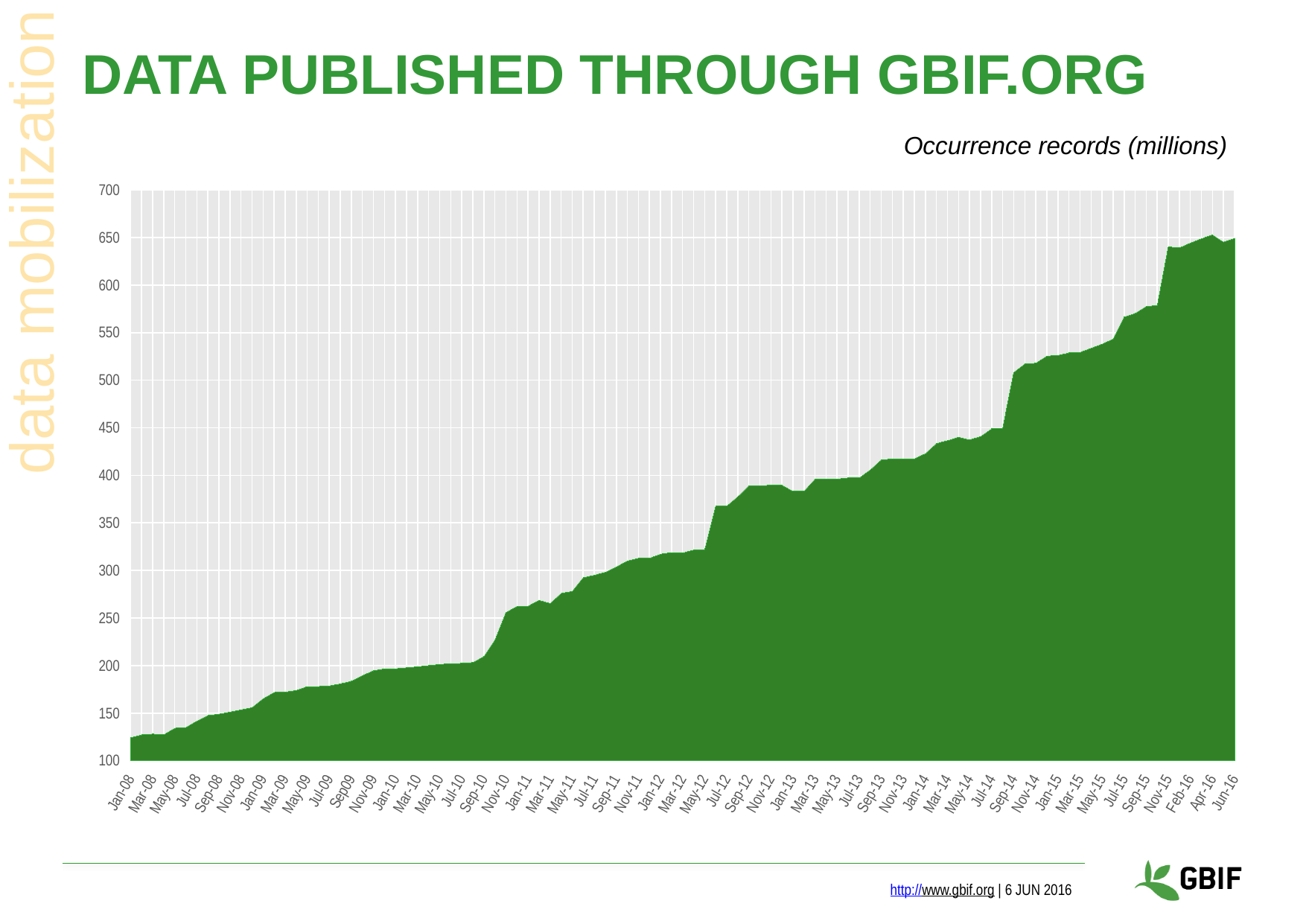
Do the occurrence record values rise or fall from Jan-08 to Jun-16? Rise Which is larger, the value for Jan-12 or the value for Jan-15? Jan-15 Is the value for Sep-14 greater or less than 500? greater Which date has the lowest number of occurrence records? Jan-08 Is the value for Jan-14 greater or less than 400? greater What unit is the y axis measured in, according to the label above the chart? Occurrence records (millions) Is the value for Jan-11 greater or less than 250? greater What is the title of the chart? DATA PUBLISHED THROUGH GBIF.ORG What kind of chart is shown on the slide? Area chart